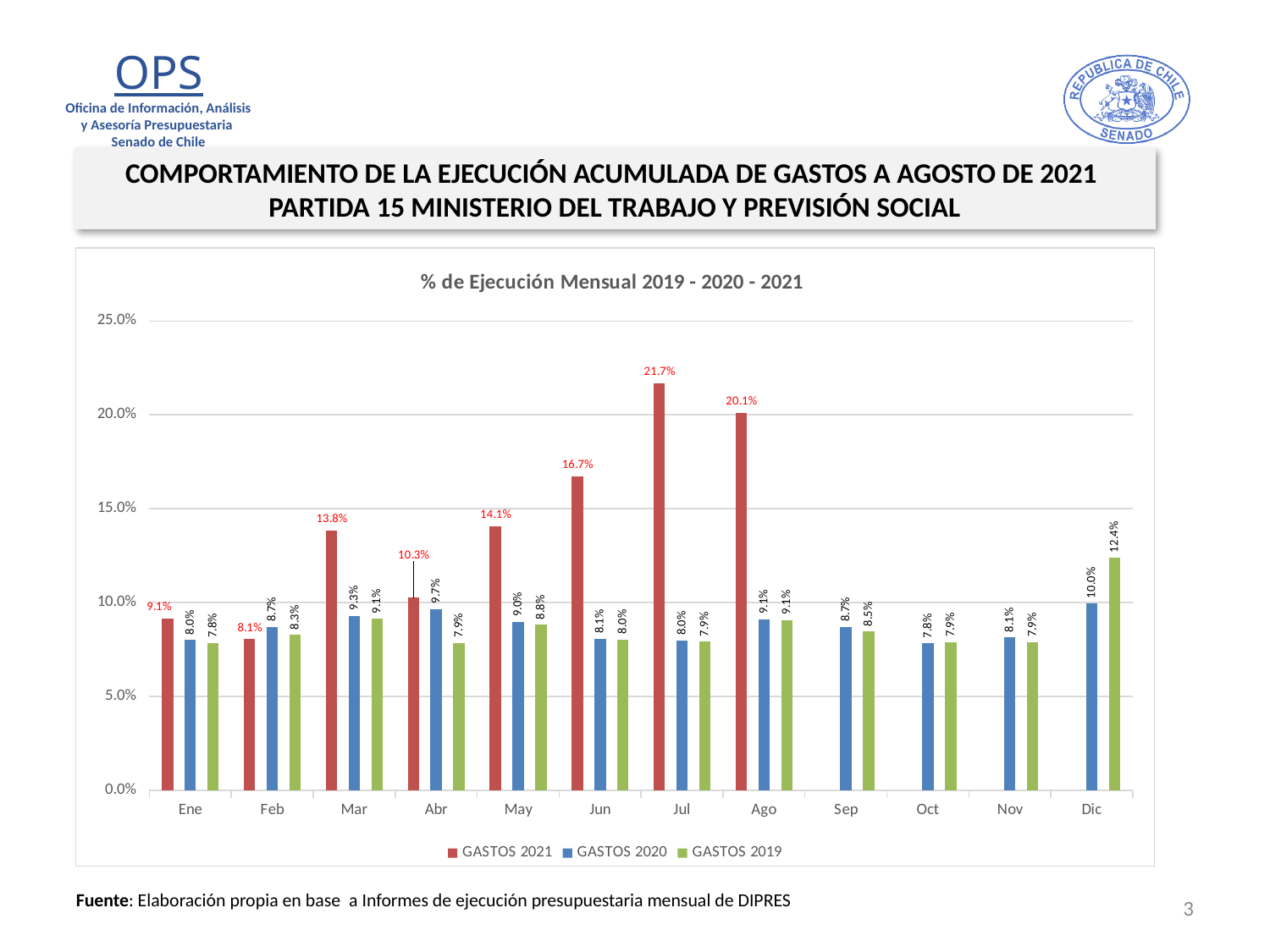
In which month is the GASTOS 2021 value highest? Jul Is the value for GASTOS 2021 in Jun greater or less than 15.0%? greater How many months are shown on the x axis? 12 What is the value for GASTOS 2021 in Jul? 21.7% What is the value for GASTOS 2019 in Abr? 7.9% Which is larger in Feb: GASTOS 2021 or GASTOS 2020? GASTOS 2020 In which month is the GASTOS 2020 value lowest? Oct What is the difference between the GASTOS 2021 value in Jul and the GASTOS 2021 value in Ago? 1.6% How many series does the legend list? 3 In which month is the GASTOS 2019 value highest? Dic What is the value for GASTOS 2020 in Dic? 10.0% What kind of chart is shown on the slide? Bar chart